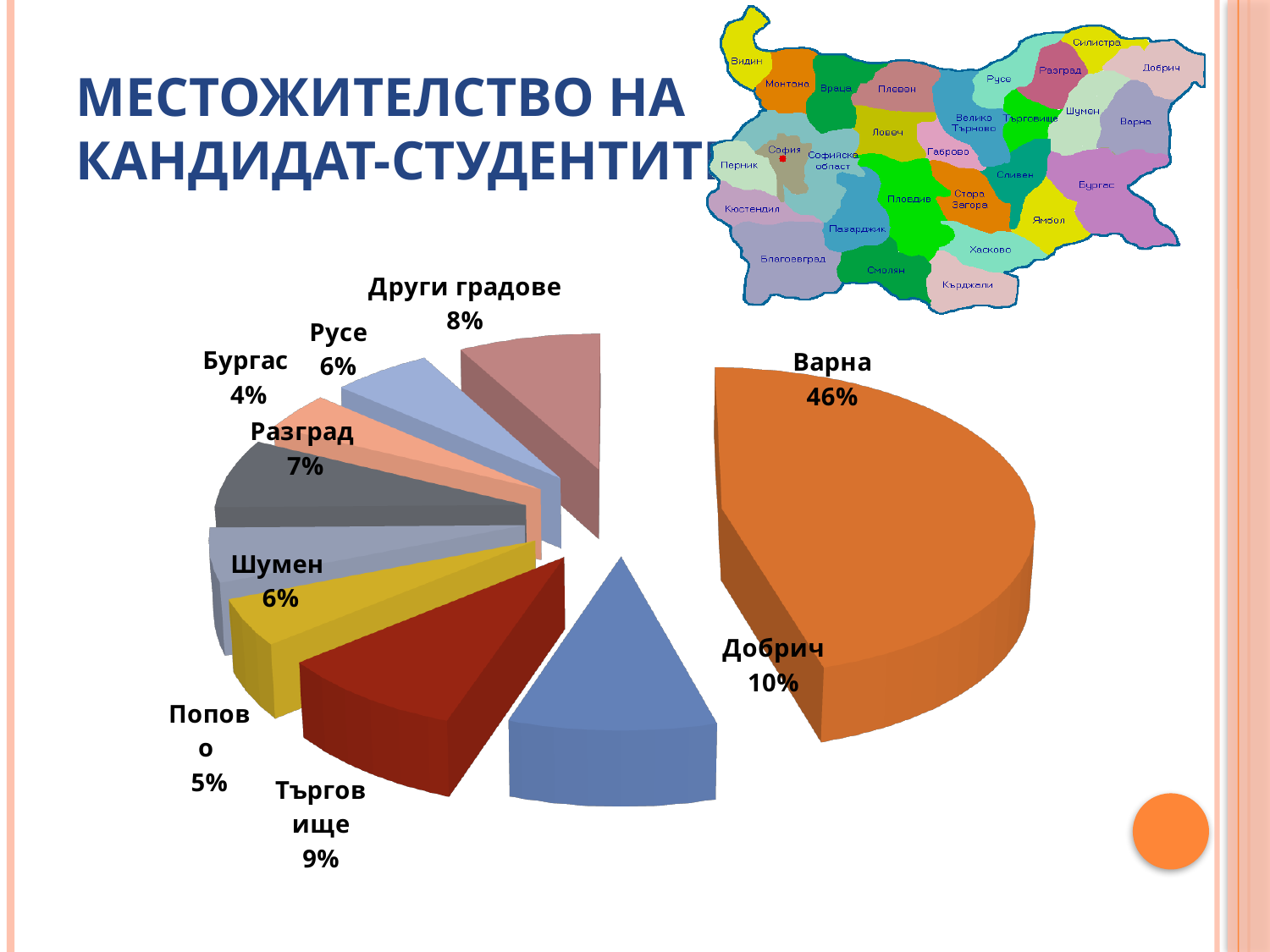
What is the value shown for Търговище? 9% What share of the pie does Варна have? 46% How many slices does the pie chart have? 9 Which is larger, the slice for Попово or the slice for Шумен? Шумен What is the difference in percentage points between Варна and Добрич? 36 Which category has the smallest slice of the pie? Бургас What is the value shown for Други градове? 8% What colour is the slice for Варна? orange What kind of chart is shown on the slide? pie chart What is the value shown for Разград? 7% Which category has the largest slice of the pie? Варна What share of the pie does Добрич have? 10%